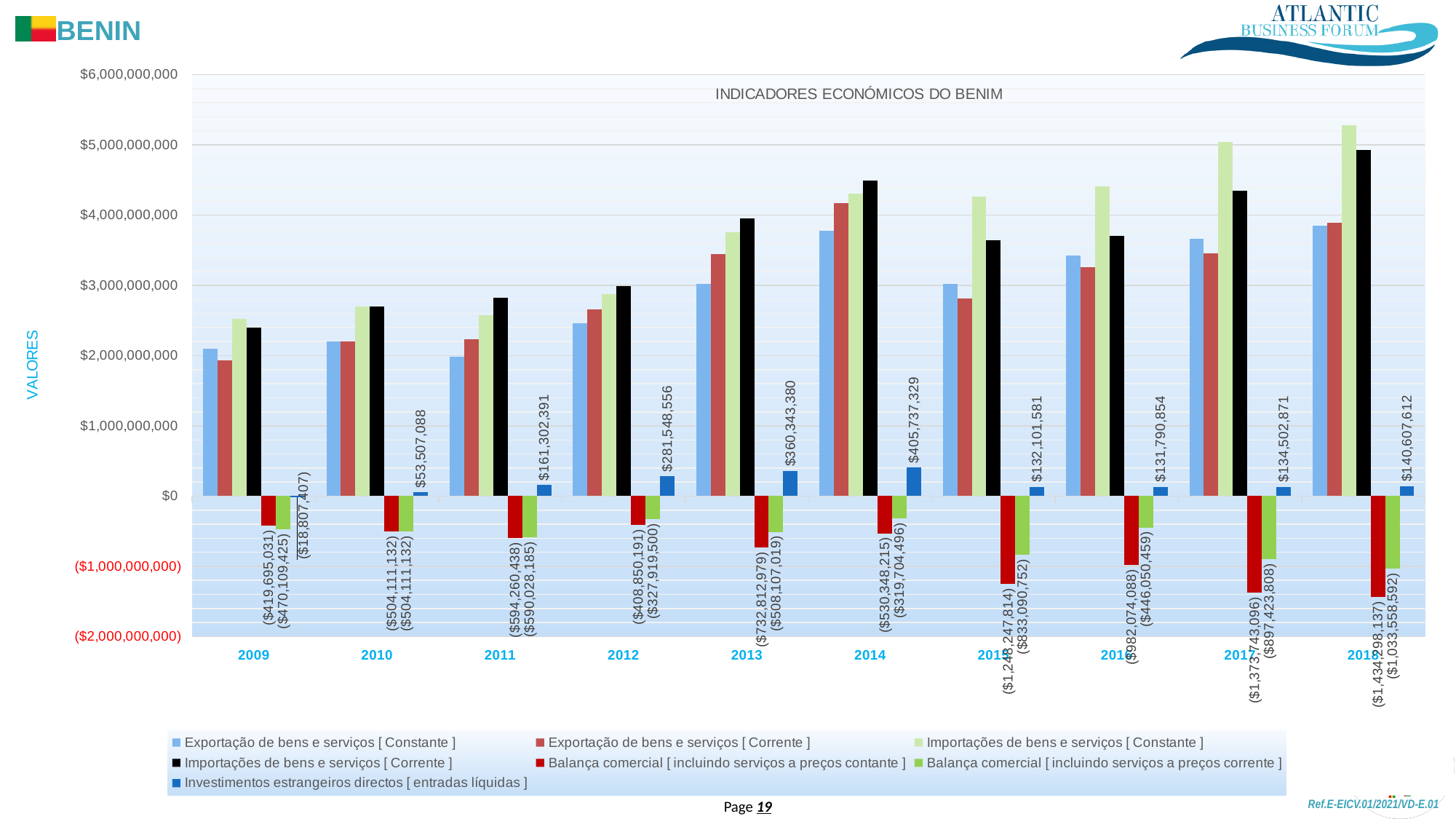
Which year has the larger value for Investimentos estrangeiros directos [ entradas líquidas ], 2012 or 2013? 2013 In which year is Investimentos estrangeiros directos [ entradas líquidas ] lowest? 2009 In which year is Investimentos estrangeiros directos [ entradas líquidas ] highest? 2014 What is the title of the chart? INDICADORES ECONÓMICOS DO BENIM Is the value for Importações de bens e serviços [ Corrente ] in 2018 greater or less than $4,000,000,000? greater Is the value for Exportação de bens e serviços [ Constante ] in 2009 greater or less than $3,000,000,000? less How many series does the chart legend list? 7 What is the value of Balança comercial [ incluindo serviços a preços contante ] in 2018? ($1,434,298,137) What is the value of Balança comercial [ incluindo serviços a preços corrente ] in 2010? ($504,111,132) What is the value of Investimentos estrangeiros directos [ entradas líquidas ] in 2014? $405,737,329 How many years are shown on the x axis of the chart? 10 What kind of chart is shown on the slide? bar chart